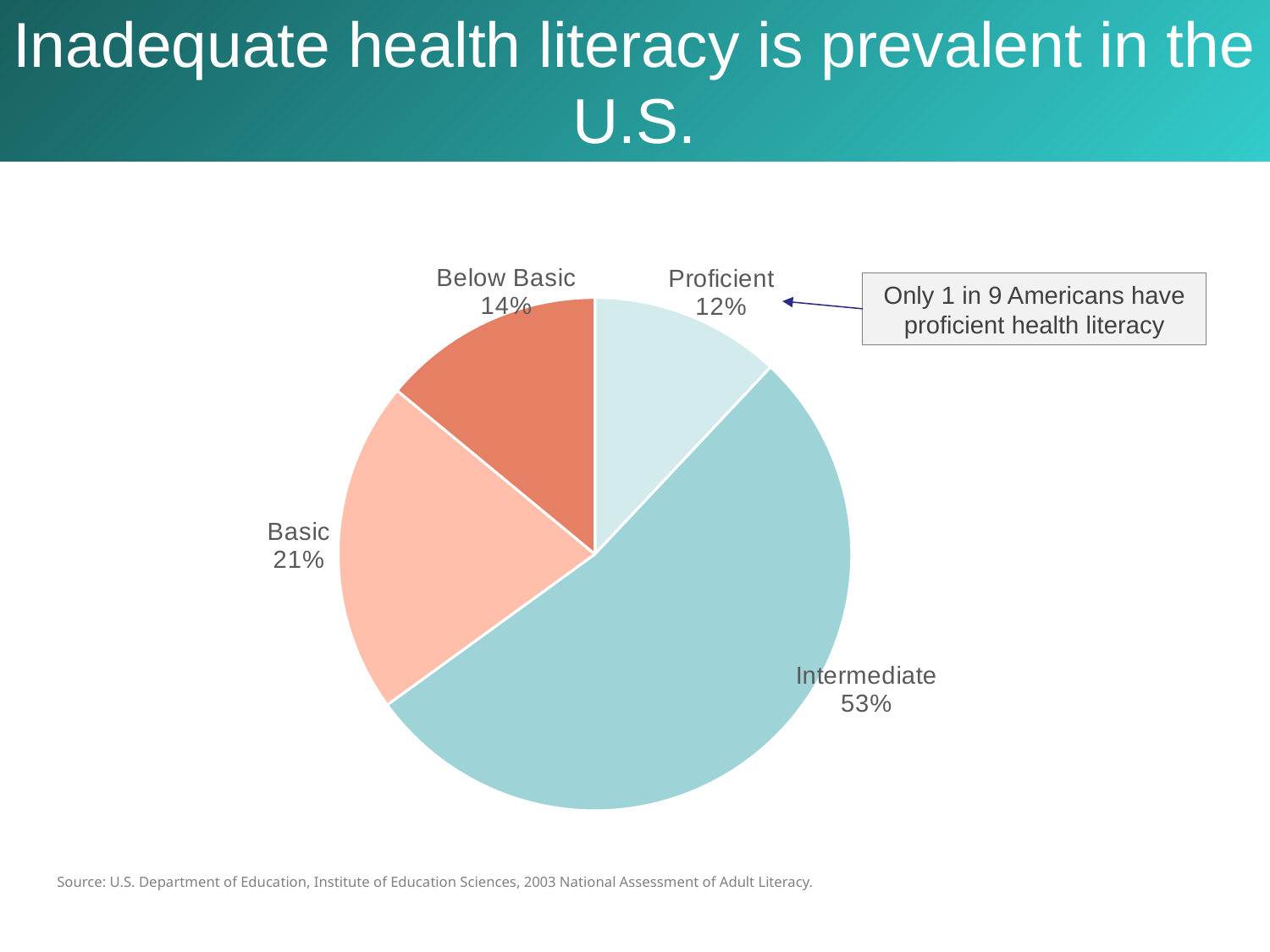
What is the value shown for the Below Basic slice? 14% What is the value shown for the Proficient slice? 12% What does the callout box next to the Proficient slice say? Only 1 in 9 Americans have proficient health literacy Which category has the smallest slice of the pie? Proficient What is the value shown for the Basic slice? 21% What kind of chart is shown on the slide? pie chart What is the difference between the Intermediate and Basic percentages? 32% What is the combined share of the Basic and Below Basic slices? 35% What percentage of the pie is labelled Intermediate? 53% How many slices does the pie chart have? 4 Which is larger, the Basic slice or the Below Basic slice? Basic Which category has the largest slice of the pie? Intermediate